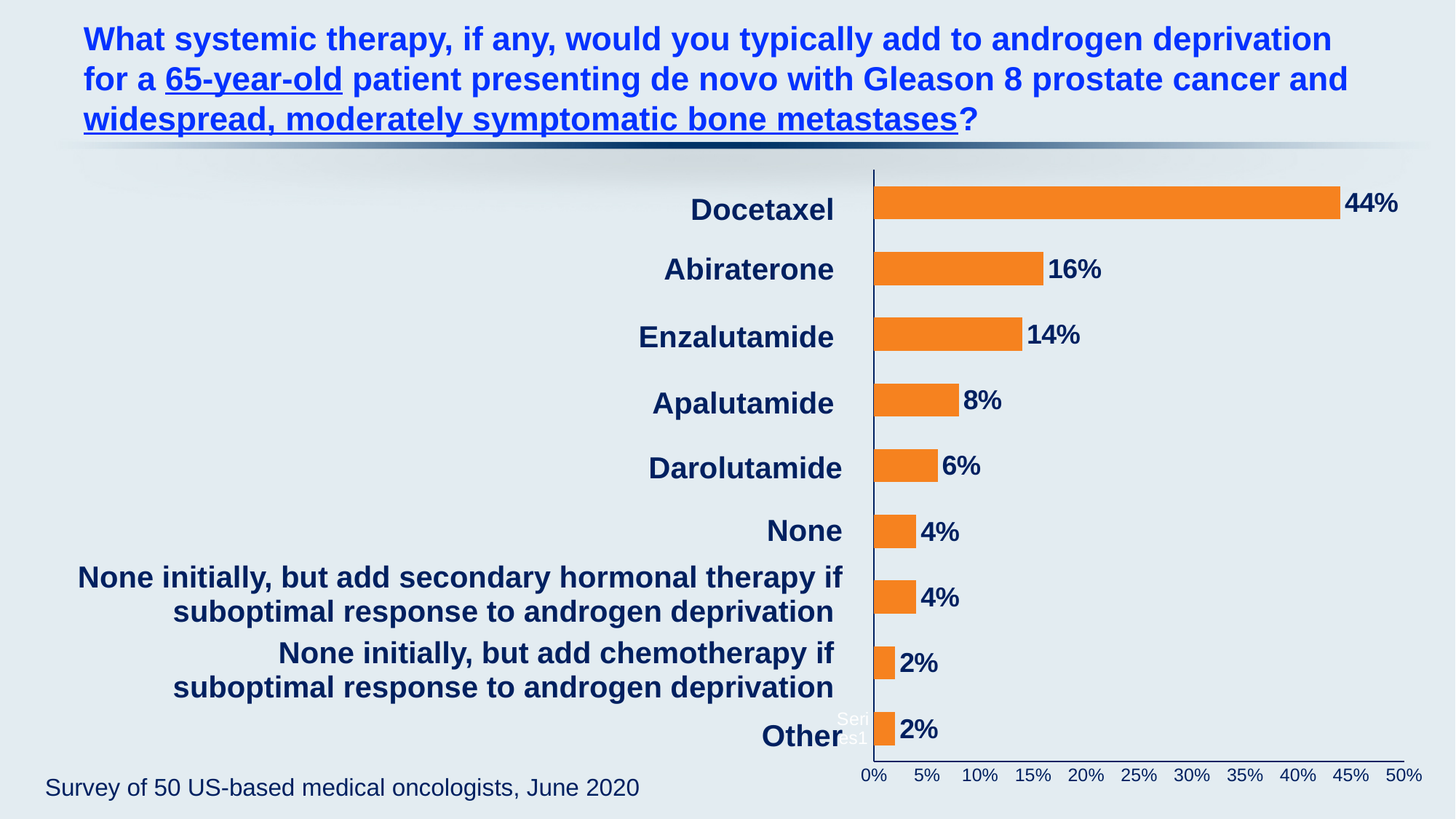
How many categories are shown in the chart? 9 Is the value for Docetaxel greater or less than 40%? greater What kind of chart is shown on the slide? Bar chart Which has a larger value, Apalutamide or None? Apalutamide What is the difference between Apalutamide and Darolutamide? 2% What is the difference in percentage points between Docetaxel and Abiraterone? 28 What is the maximum value shown on the x axis? 50% What is the value shown for Enzalutamide? 14% What percentage of respondents chose Docetaxel? 44% What percentage is shown for Darolutamide? 6% Which therapy option has the highest percentage? Docetaxel Which has a larger value, Abiraterone or Enzalutamide? Abiraterone